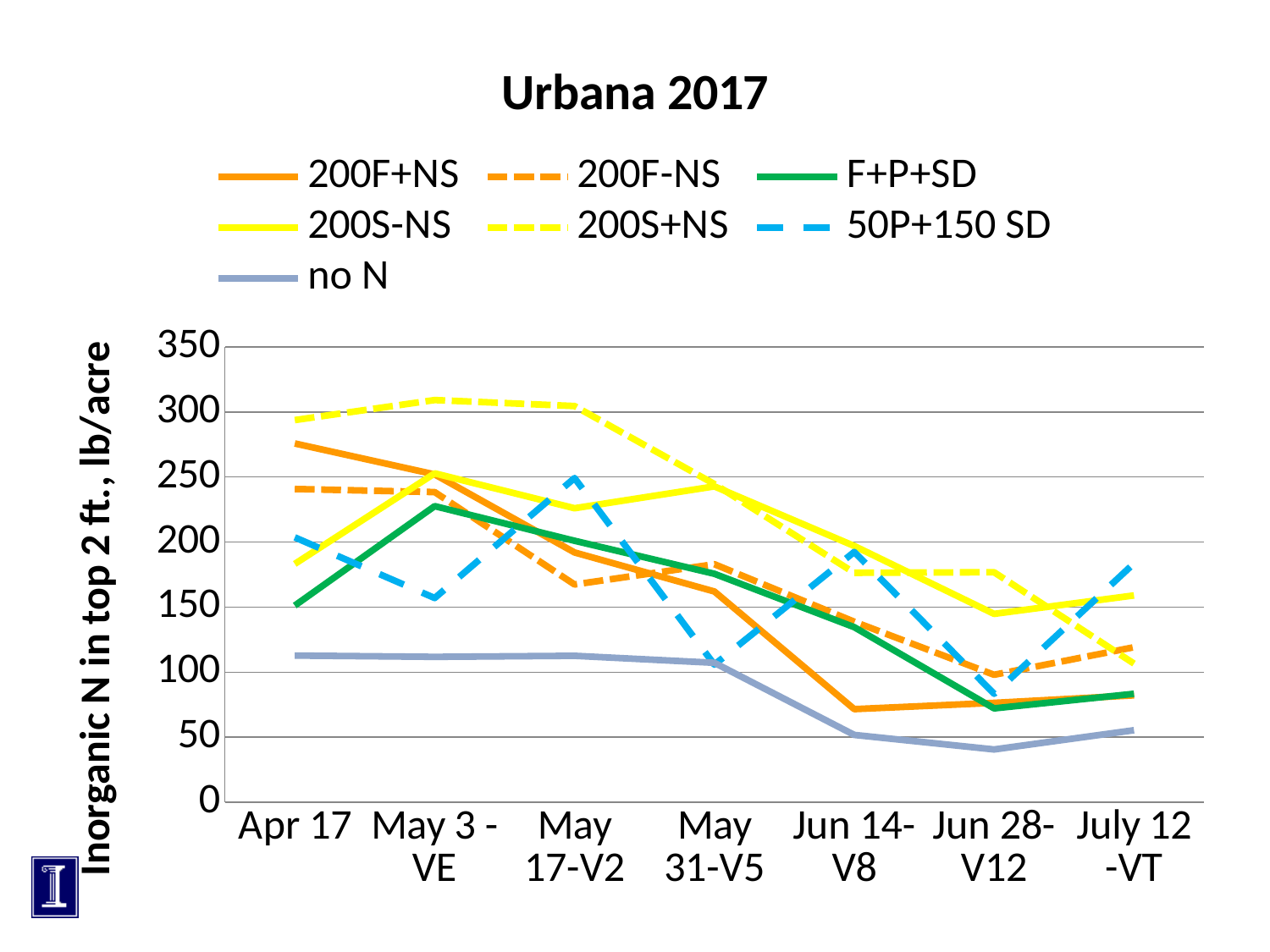
What is the title of the chart? Urbana 2017 Does the 200F+NS series rise or fall from Apr 17 to Jun 28-V12? fall How many sampling dates are shown along the x axis? 7 Which series has the highest value on Apr 17? 200S+NS Is the value for no N on Apr 17 greater or less than 150? less Which series has the lowest value on Jun 28-V12? no N Is the value for 200S+NS on May 3 - VE greater or less than 250? greater How many series does the legend list? 7 On May 17-V2, which is larger: the value for 200S+NS or the value for no N? 200S+NS Is the value for 200F+NS on Jun 14-V8 greater or less than 100? less What kind of chart is shown on the slide? line chart What is the label on the y axis? Inorganic N in top 2 ft., lb/acre